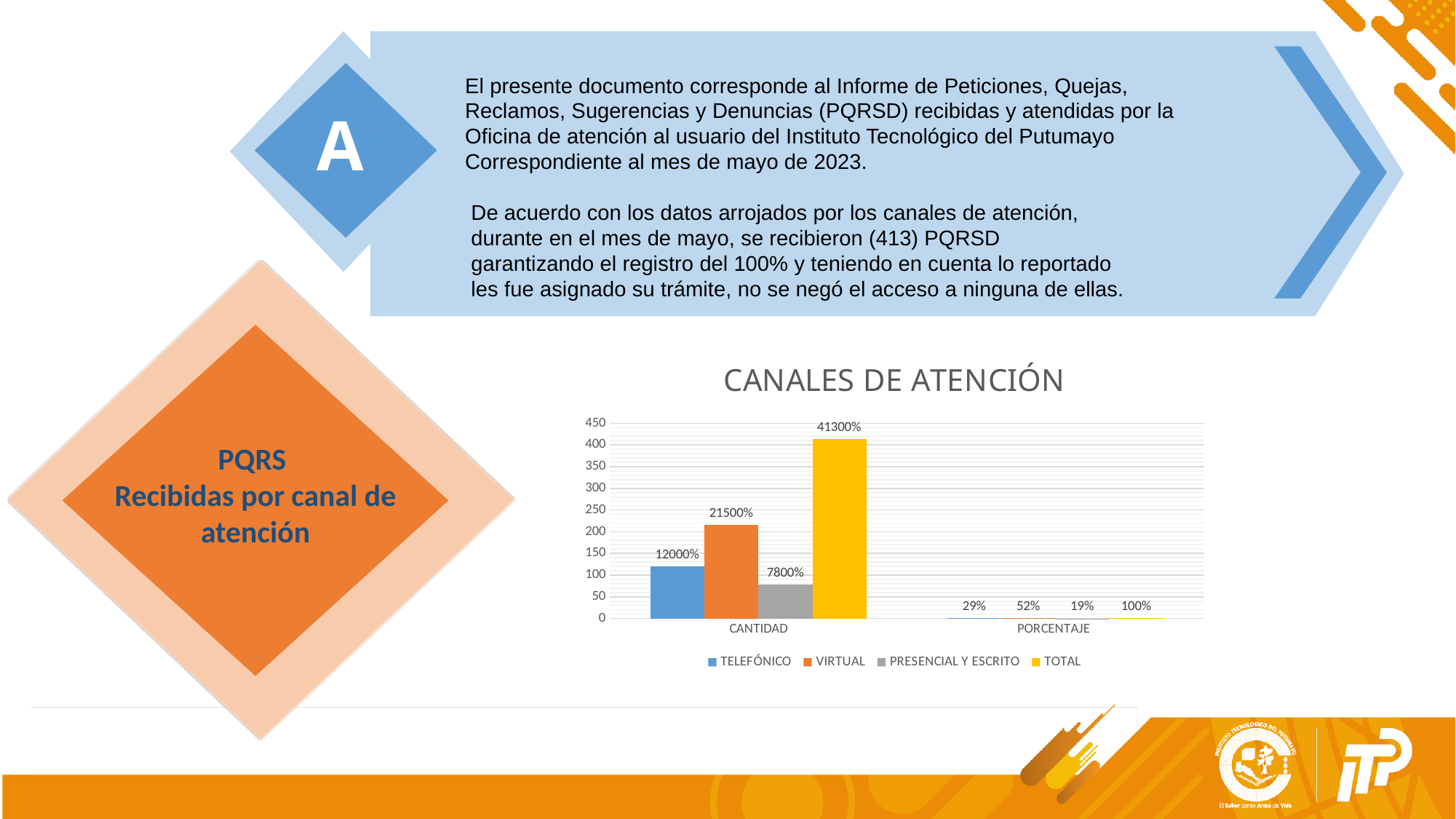
What is the data label for TELEFÓNICO in the CANTIDAD category? 12000% Which series has the tallest bar in the CANTIDAD category? TOTAL How many series does the legend of the CANALES DE ATENCIÓN chart list? 4 In the CANTIDAD category, which bar is taller: VIRTUAL or TELEFÓNICO? VIRTUAL What is the data label for TOTAL in the CANTIDAD category? 41300% How many categories are shown on the x axis of the CANALES DE ATENCIÓN chart? 2 What is the data label for PRESENCIAL Y ESCRITO in the CANTIDAD category? 7800% Is the VIRTUAL bar in the CANTIDAD category greater or less than 200 on the axis? greater What kind of chart is shown under the title CANALES DE ATENCIÓN? bar chart What is the data label for VIRTUAL in the PORCENTAJE category? 52% What is the data label for VIRTUAL in the CANTIDAD category? 21500% Which series has the shortest bar in the CANTIDAD category? PRESENCIAL Y ESCRITO